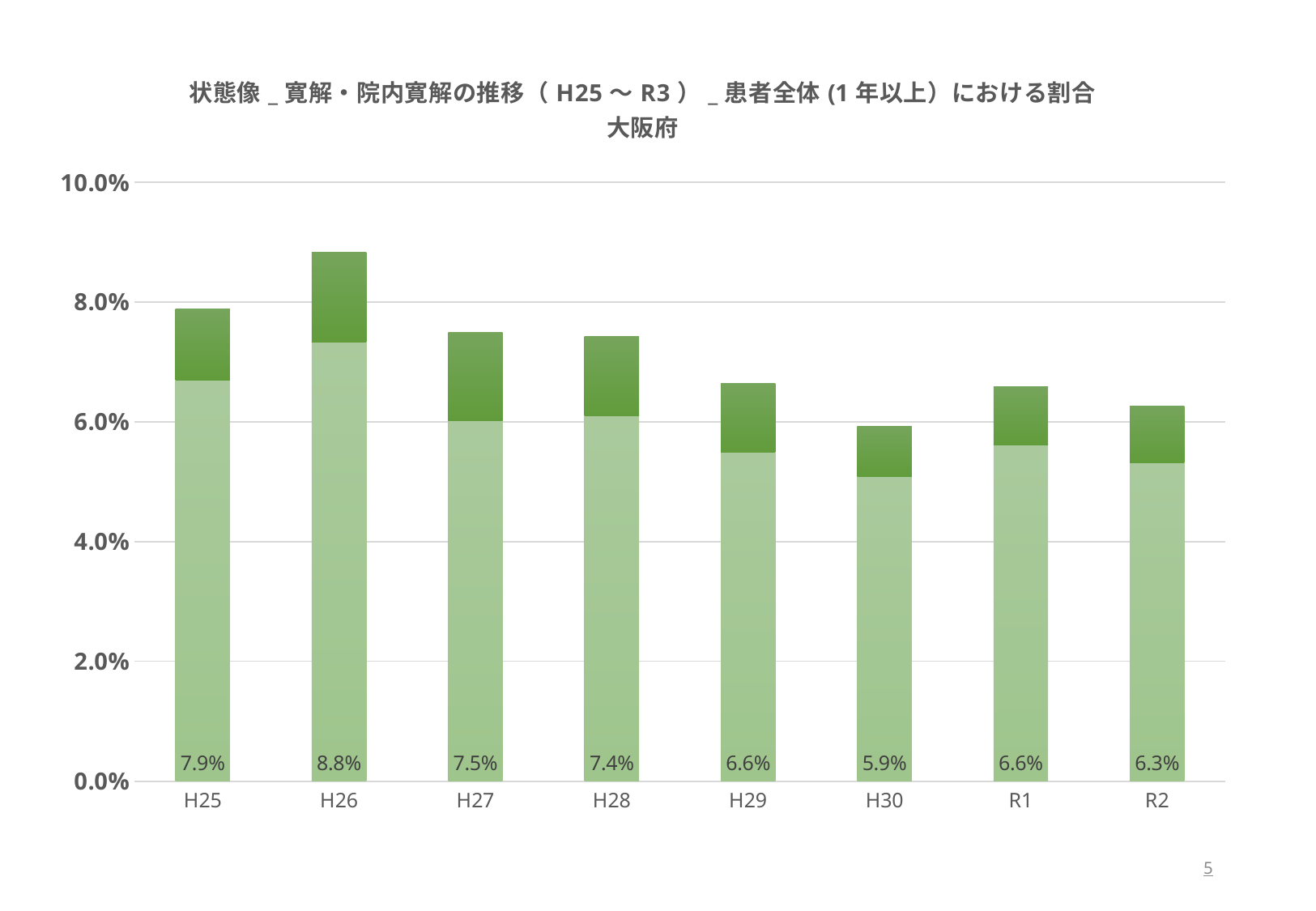
What is the labeled value for H26? 8.8% How many years are shown on the x axis? 8 What is the difference between the labeled values for H26 and H25? 0.9% Which year has the highest labeled value? H26 What is the difference between the labeled values for H27 and R2? 1.2% What is the labeled value for H30? 5.9% What kind of chart is shown on the slide? Stacked bar chart Do the labeled values rise or fall from H26 to H30? Fall Which year has the lowest labeled value? H30 Is the light green (lower) segment of the H25 bar greater or less than 6.0%? greater Which is larger, the labeled value for H28 or for R1? H28 What is the labeled value for R2? 6.3%